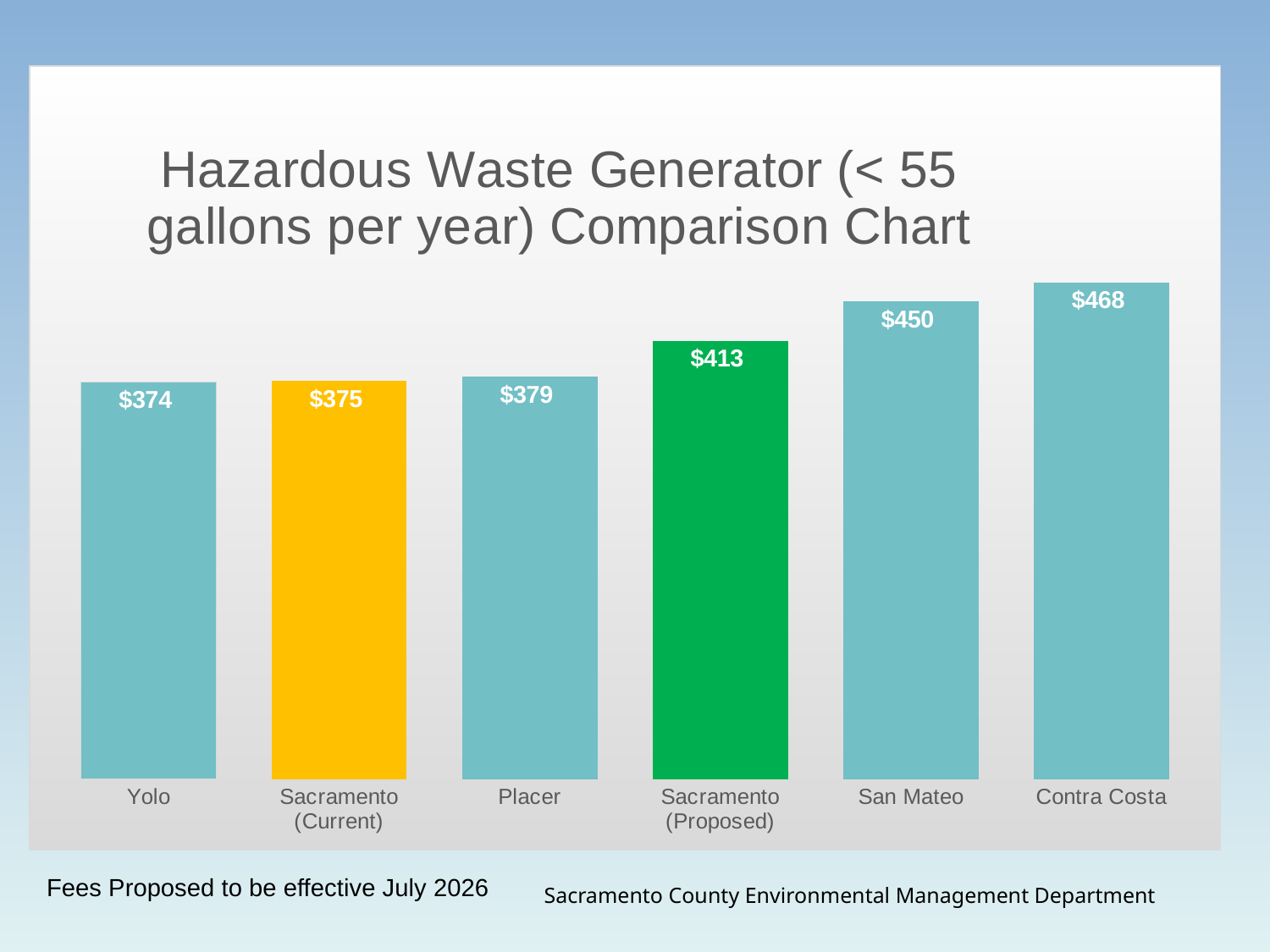
Do the values rise or fall from left to right across the categories? Rise Which is larger, the value for San Mateo or the value for Sacramento (Proposed)? San Mateo What colour is the Sacramento (Current) bar? Yellow Which category has the highest value? Contra Costa What is the value for San Mateo? $450 What is the difference between the Sacramento (Proposed) and Sacramento (Current) values? $38 Which category has the lowest value? Yolo What is the value for Yolo? $374 How many categories are shown in the chart? 6 What is the value for Sacramento (Proposed)? $413 What is the difference between the Contra Costa and Placer values? $89 What kind of chart is shown on the slide? Bar chart